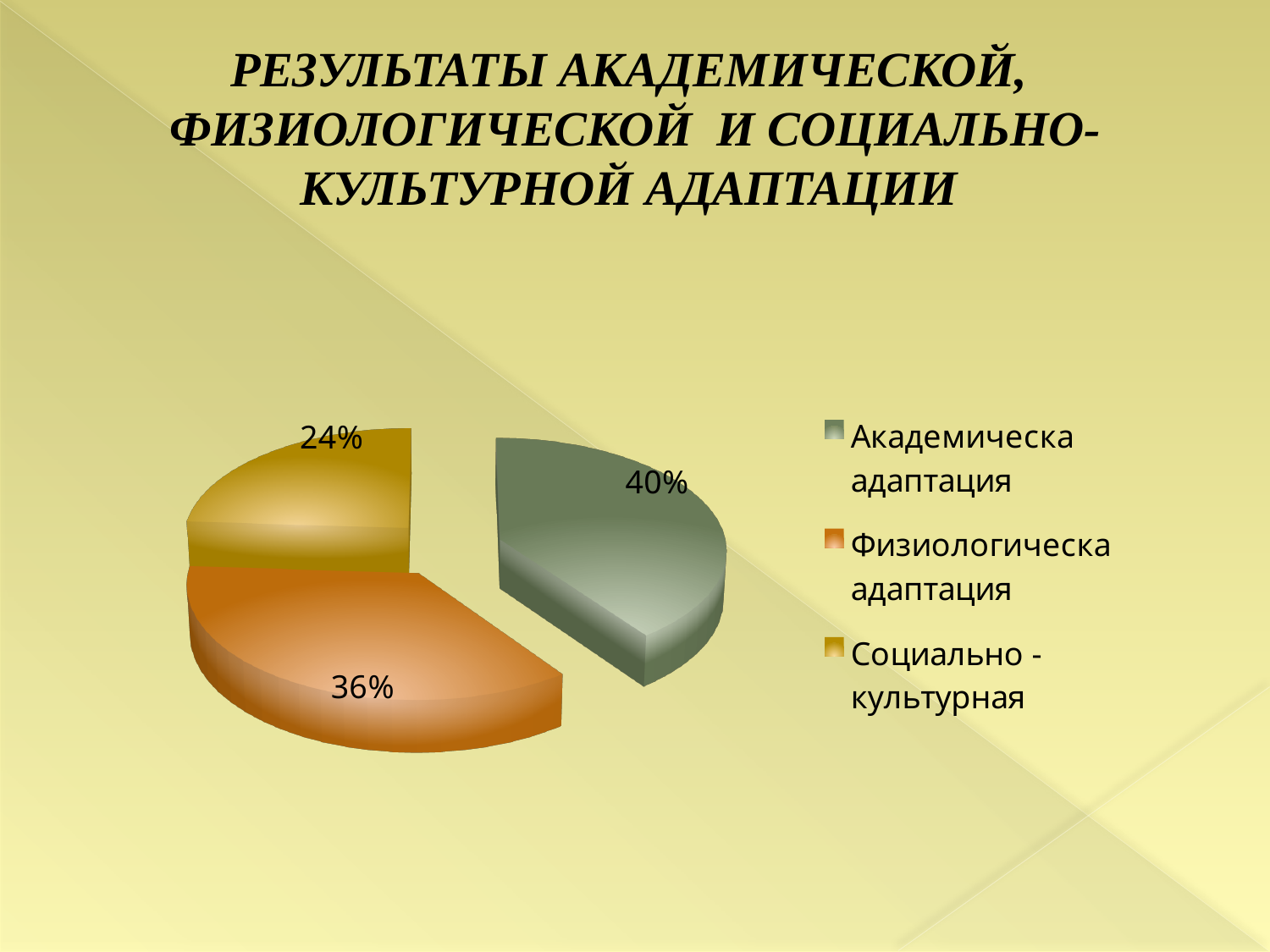
How many slices does the pie chart have? 3 What is the difference between the shares of Академическа адаптация and Социально - культурная? 16% What kind of chart is shown on the slide? pie chart What colour is the slice for Физиологическа адаптация? orange What percentage is shown for Социально - культурная? 24% Which category has the smallest share of the pie? Социально - культурная What is the difference between the shares of Физиологическа адаптация and Социально - культурная? 12% Which is larger, the share for Академическа адаптация or for Физиологическа адаптация? Академическа адаптация What percentage is shown for Физиологическа адаптация? 36% How many entries does the legend list? 3 What percentage is shown for Академическа адаптация? 40% Which category has the largest share of the pie? Академическа адаптация